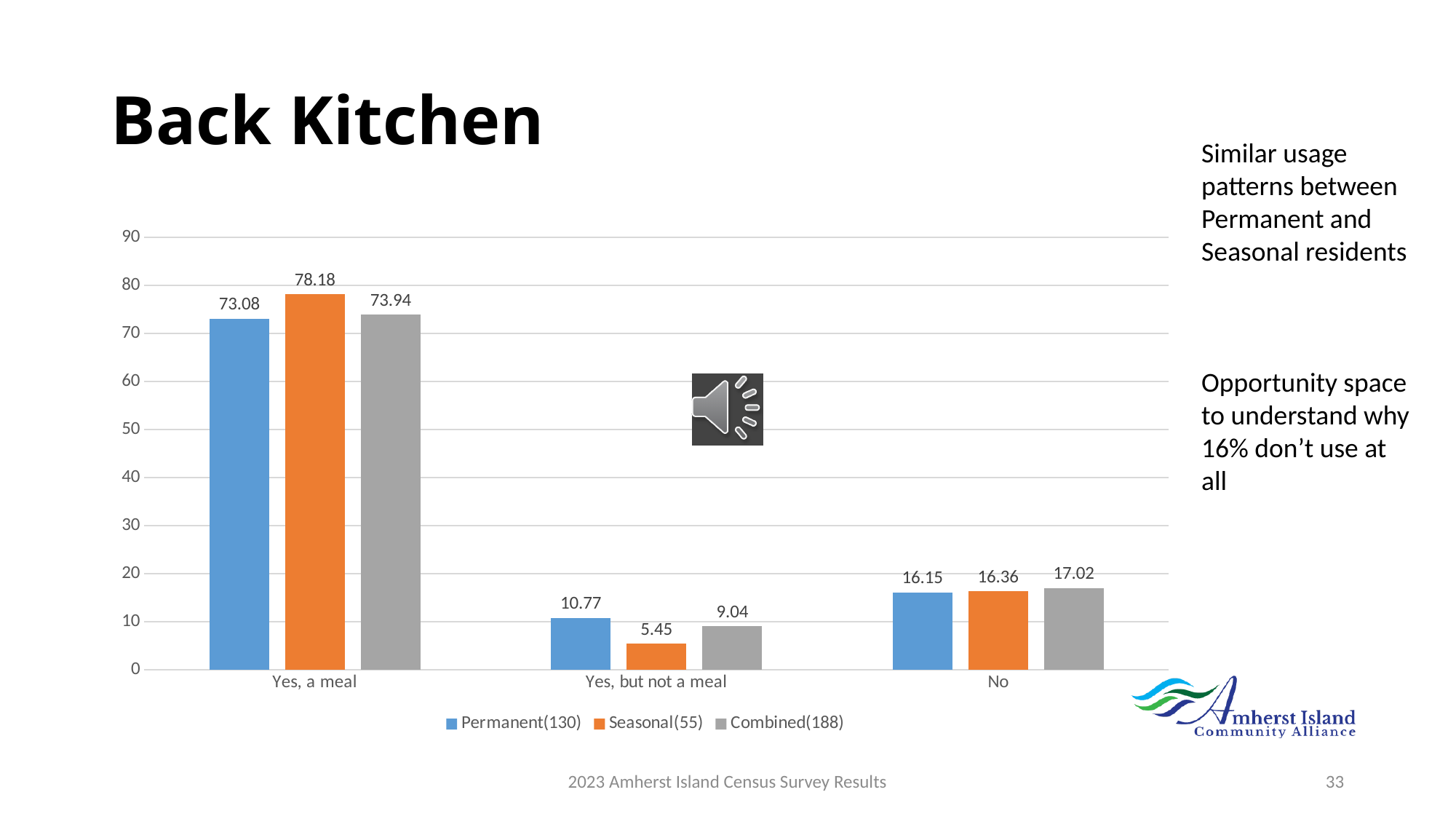
Which category has the highest value for Seasonal(55)? Yes, a meal In the 'Yes, but not a meal' category, which is larger: Permanent(130) or Seasonal(55)? Permanent(130) Is the Combined(188) value for 'Yes, a meal' greater or less than 70? greater What kind of chart is shown on the slide? Bar chart What colour are the Seasonal(55) bars? Orange What is the value for Permanent(130) in the 'Yes, a meal' category? 73.08 Which category has the lowest value for Permanent(130)? Yes, but not a meal How many series does the legend list? 3 What is the value for Combined(188) in the 'No' category? 17.02 How many categories are shown on the x axis? 3 What is the value for Seasonal(55) in the 'Yes, but not a meal' category? 5.45 What is the difference between the Seasonal(55) and Permanent(130) values in the 'Yes, a meal' category? 5.1